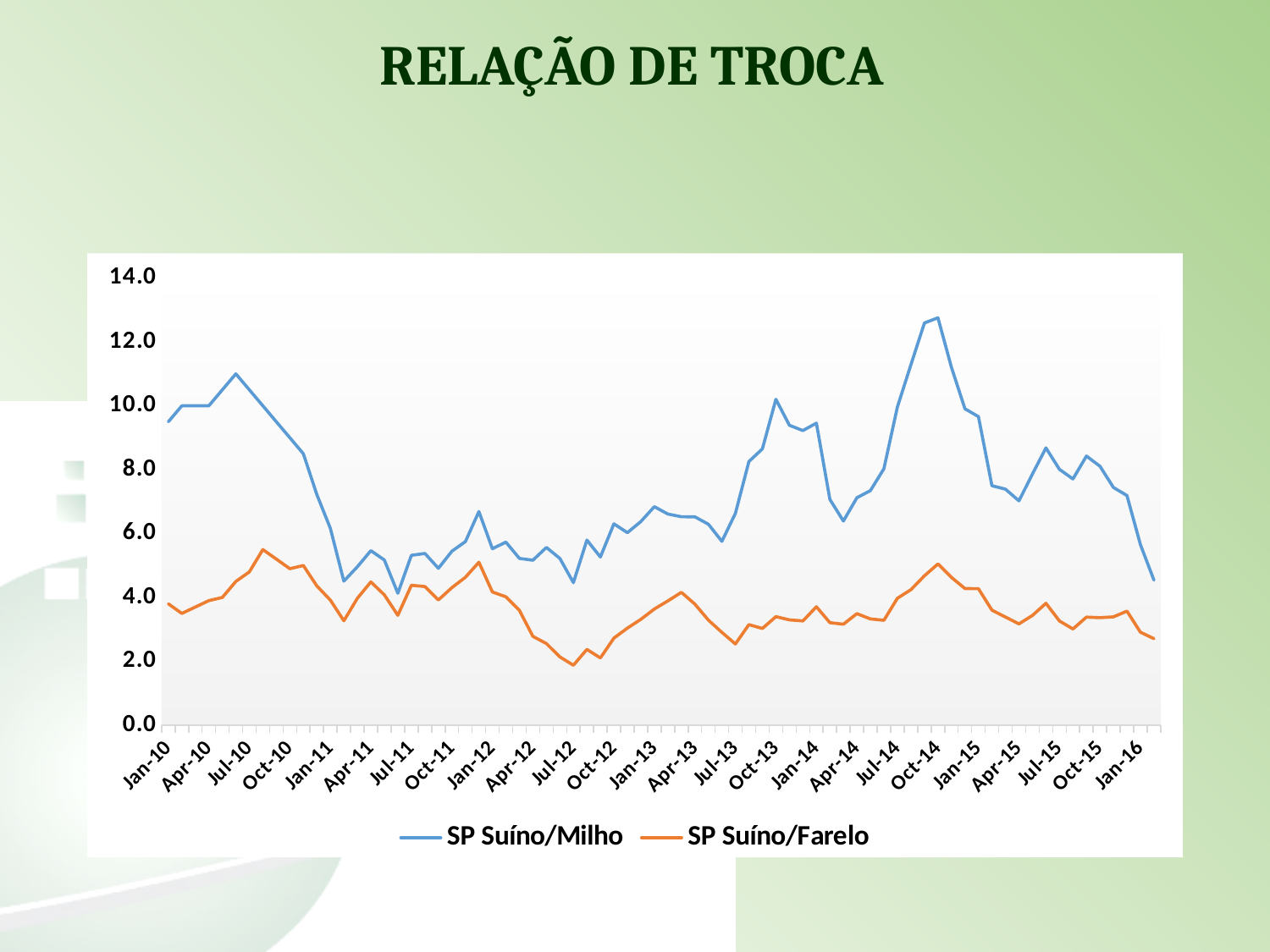
Is the value for SP Suíno/Farelo at Jul-12 greater or less than 4.0? less In which year does SP Suíno/Milho reach its highest value? 2014 What kind of chart is shown on the slide? line chart Is the value for SP Suíno/Milho at Oct-14 greater or less than 12.0? greater Is the value for SP Suíno/Milho at Jan-10 greater or less than 8.0? greater What is the title of the slide? RELAÇÃO DE TROCA Which series has the higher value at Oct-14, SP Suíno/Milho or SP Suíno/Farelo? SP Suíno/Milho How many series does the legend list? 2 Which series reaches the highest value on the chart? SP Suíno/Milho Which series is drawn in orange? SP Suíno/Farelo Does SP Suíno/Milho rise or fall between Oct-14 and Jan-16? fall